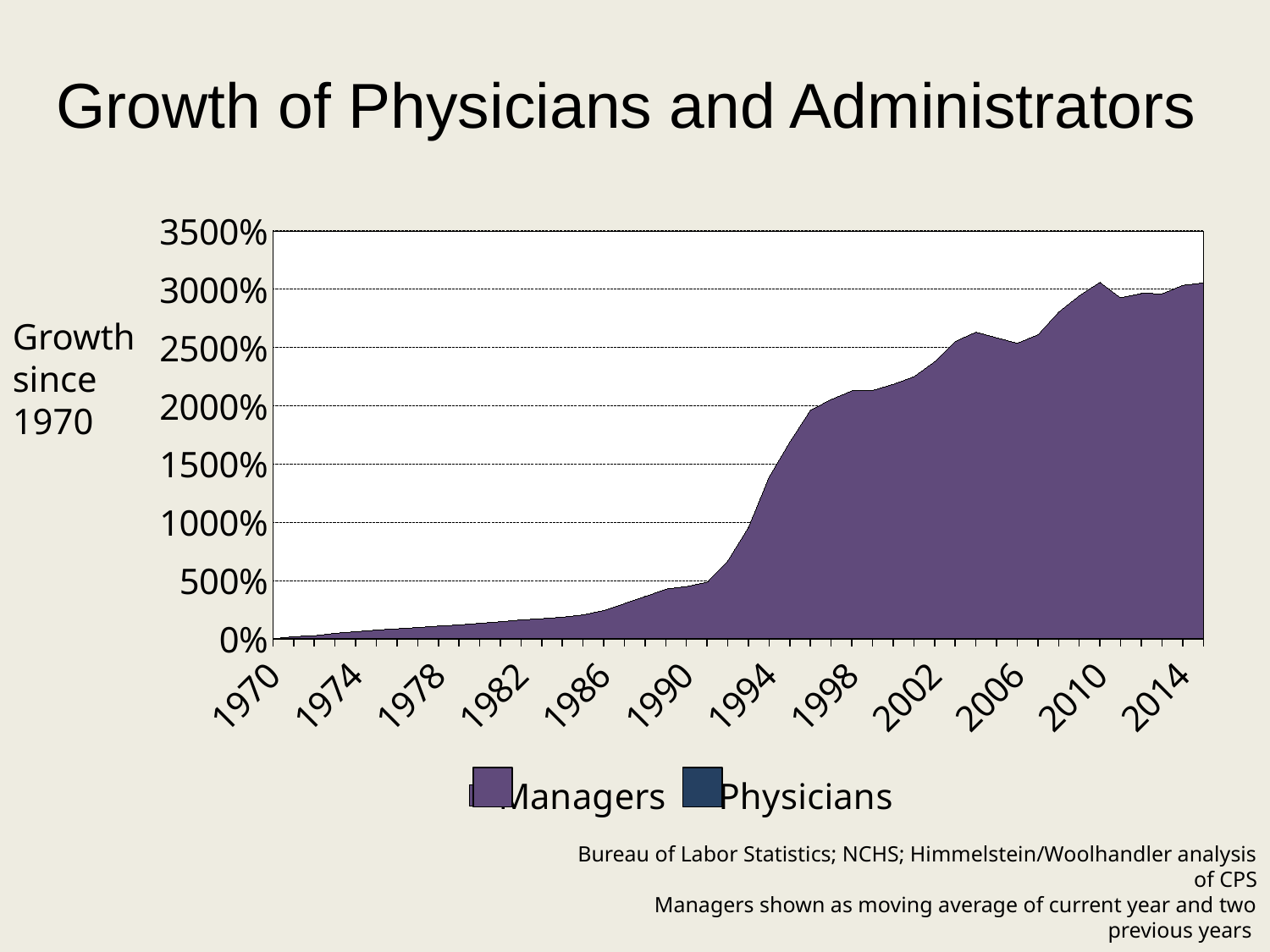
Is the value for Managers in 1990 greater or less than 1000%? less In which year is the Managers series at its lowest? 1970 How many series does the legend list? 2 Does the Managers series generally rise or fall from 1970 to 2014? rise Is the value for Managers in 1982 greater or less than 500%? less What kind of chart is shown on the slide? area chart Is the value for Managers in 2014 greater or less than 2500%? greater What are the two series named in the legend? Managers and Physicians What is the title of the chart? Growth of Physicians and Administrators Which is larger for Managers: the value in 1994 or the value in 2006? 2006 How many year labels are shown on the x axis? 12